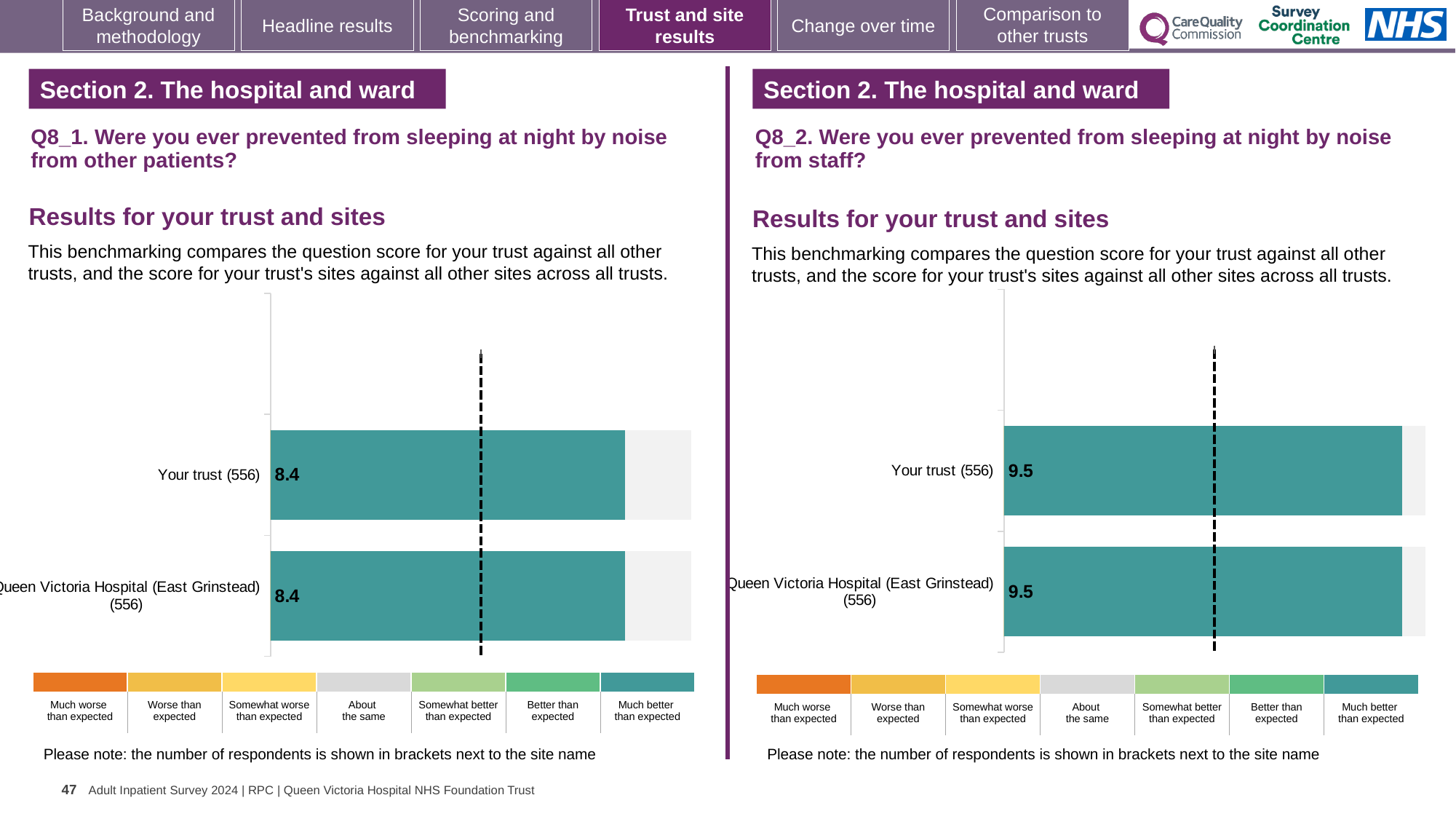
In the Q8_2 chart on the right, what is the score for Your trust (556)? 9.5 In the Q8_2 chart on the right, what is the score for Queen Victoria Hospital (East Grinstead) (556)? 9.5 How many categories does the colour legend below the Q8_2 chart on the right list? 7 In the Q8_1 chart on the left, which benchmark category does the colour of the bars correspond to according to the legend? Much better than expected In the Q8_1 chart on the left, what is the score for Queen Victoria Hospital (East Grinstead) (556)? 8.4 In the Q8_1 chart on the left, what is the difference between the score for Your trust and the score for Queen Victoria Hospital (East Grinstead)? 0 In the Q8_2 chart on the right, what is the difference between the score for Your trust and the score for Queen Victoria Hospital (East Grinstead)? 0 In the Q8_2 chart on the right, how many respondents are shown in brackets for Your trust? 556 How many bars are plotted in the Q8_1 chart on the left? 2 What kind of chart is used for the Q8_1 results on the left? Bar chart In the Q8_1 chart on the left, what is the score for Your trust (556)? 8.4 How many bars are plotted in the Q8_2 chart on the right? 2